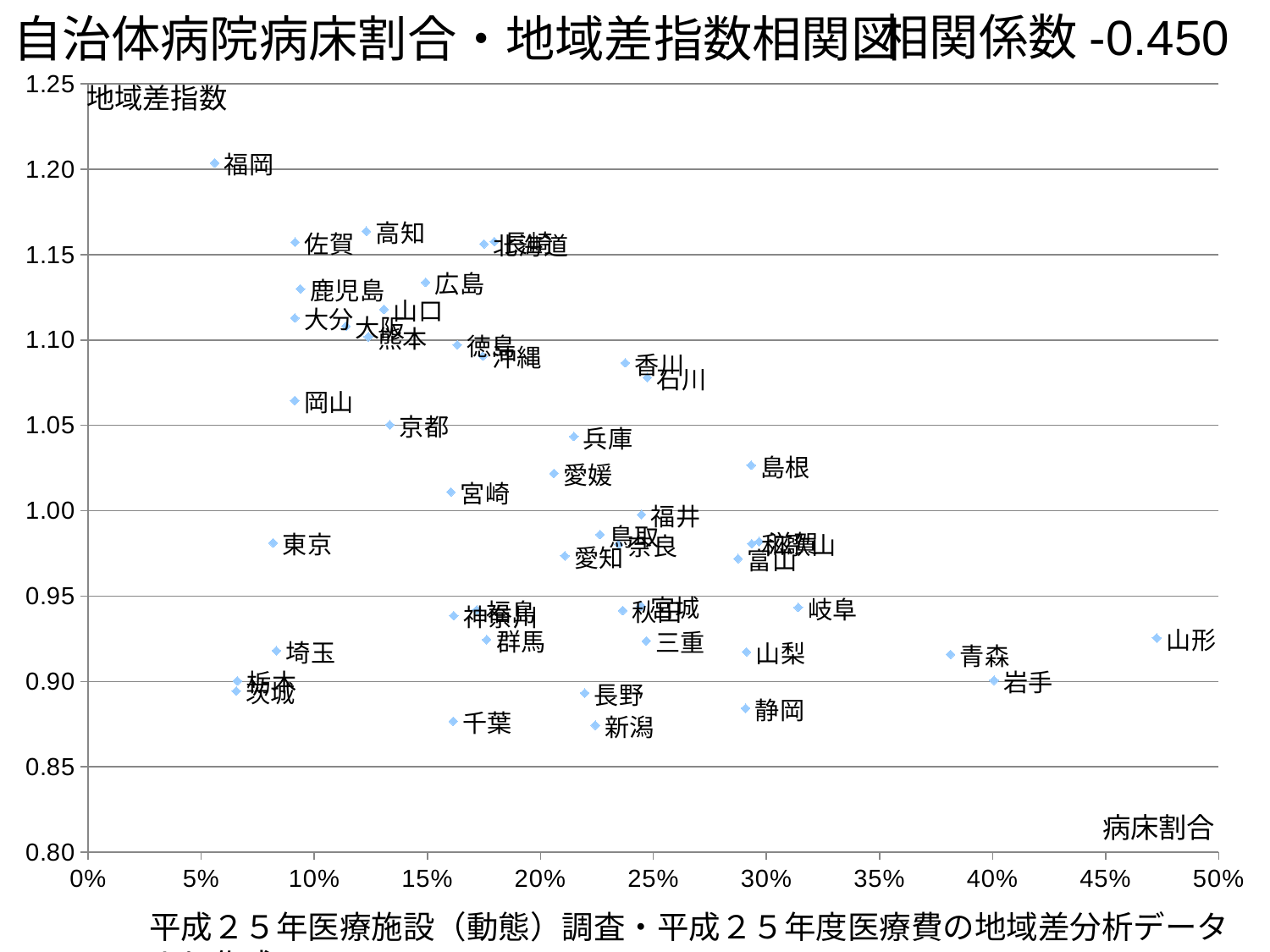
Which prefecture has the highest 地域差指数 on the chart? 福岡 What kind of chart is shown on the slide? scatter chart Which has the higher 地域差指数, 福岡 or 東京? 福岡 Which has the higher 地域差指数, 島根 or 山梨? 島根 Is the 地域差指数 for 福岡 greater or less than 1.15? greater What correlation coefficient (相関係数) is shown in the chart title? -0.450 Which has the larger 病床割合, 岩手 or 埼玉? 岩手 Is the 地域差指数 for 静岡 greater or less than 0.90? less As 病床割合 increases along the x axis, does 地域差指数 tend to rise or fall? fall Which prefecture has the highest 病床割合 on the chart? 山形 Is the 地域差指数 for 高知 greater or less than 1.15? greater